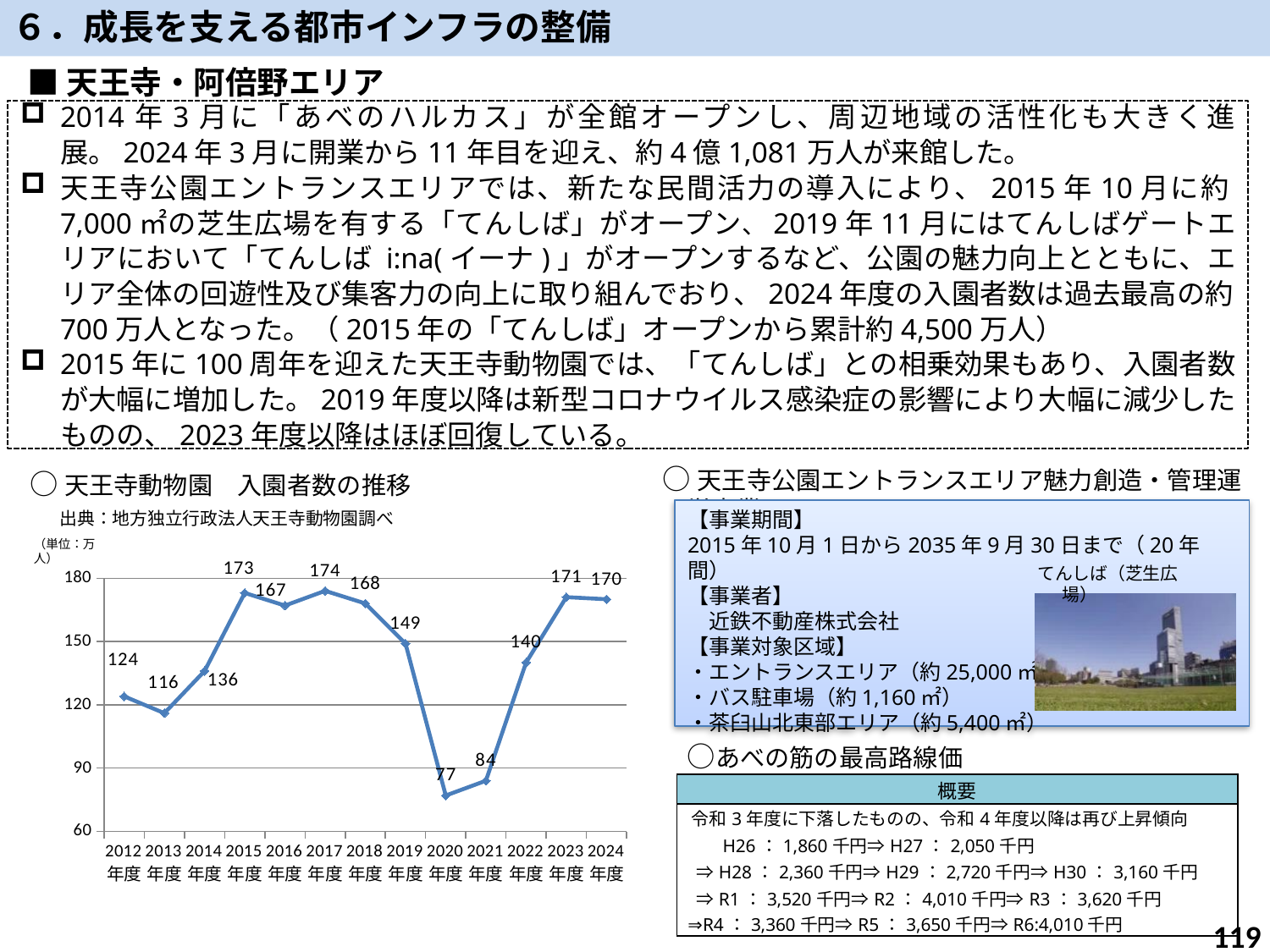
In the 天王寺動物園 入園者数の推移 chart, which is larger, the value for 2019年度 or the value for 2022年度? 2019年度 In the 天王寺動物園 入園者数の推移 chart, how many years are plotted? 13 In the 天王寺動物園 入園者数の推移 chart, what is the value for 2012年度? 124 In the 天王寺動物園 入園者数の推移 chart, which year has the highest value? 2017年度 What kind of chart is the 天王寺動物園 入園者数の推移 chart? line chart In the 天王寺動物園 入園者数の推移 chart, what is the value for 2020年度? 77 In the 天王寺動物園 入園者数の推移 chart, do the values rise or fall from 2019年度 to 2020年度? fall In the 天王寺動物園 入園者数の推移 chart, what is the difference between the values for 2015年度 and 2014年度? 37 In the 天王寺動物園 入園者数の推移 chart, which year has the lowest value? 2020年度 What unit is shown for the values in the 天王寺動物園 入園者数の推移 chart? 万人 In the 天王寺動物園 入園者数の推移 chart, what is the value for 2024年度? 170 In the 天王寺動物園 入園者数の推移 chart, what is the difference between the values for 2021年度 and 2020年度? 7